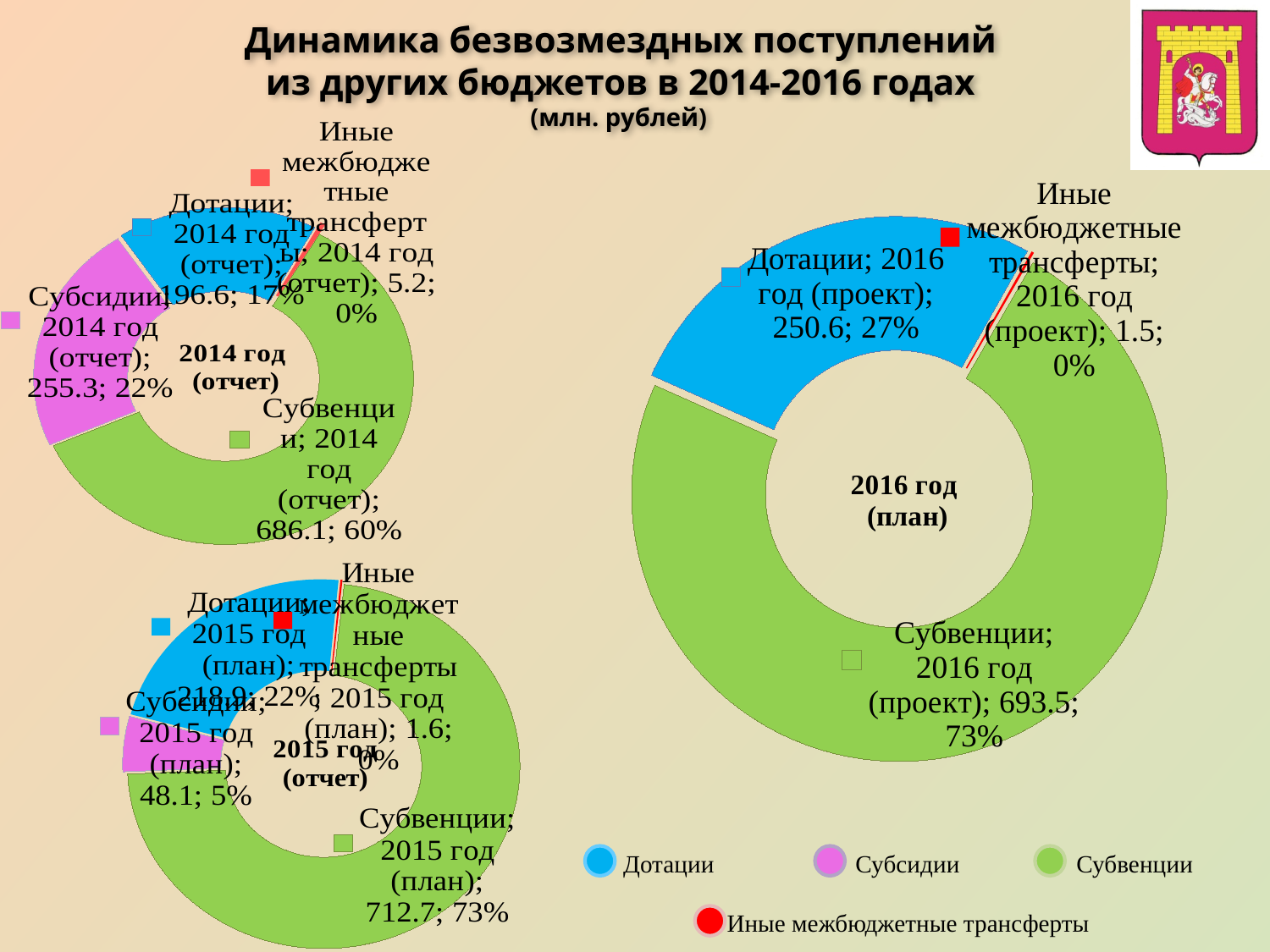
In the chart labelled "2016 год (план)", what is the value for Субвенции? 693.5 In the chart labelled "2015 год (отчет)", what is the value for Дотации? 218.9 In the chart labelled "2014 год (отчет)", which category has the largest value? Субвенции In the chart labelled "2015 год (отчет)", what is the value for Субсидии? 48.1 How many entries does the shared legend at the bottom of the slide list? 4 In the chart labelled "2014 год (отчет)", what share of the total do Субсидии make up? 22% In the chart labelled "2016 год (план)", what share of the total do Дотации make up? 27% In the chart labelled "2014 год (отчет)", which is larger: the value for Субсидии or the value for Дотации? Субсидии In the chart labelled "2014 год (отчет)", what is the value for Субвенции? 686.1 In the chart labelled "2015 год (отчет)", which category has the smallest value? Иные межбюджетные трансферты What kind of chart is used for the chart labelled "2016 год (план)"? Doughnut (pie) chart In the chart labelled "2016 год (план)", what is the difference between the values for Субвенции and Дотации? 442.9